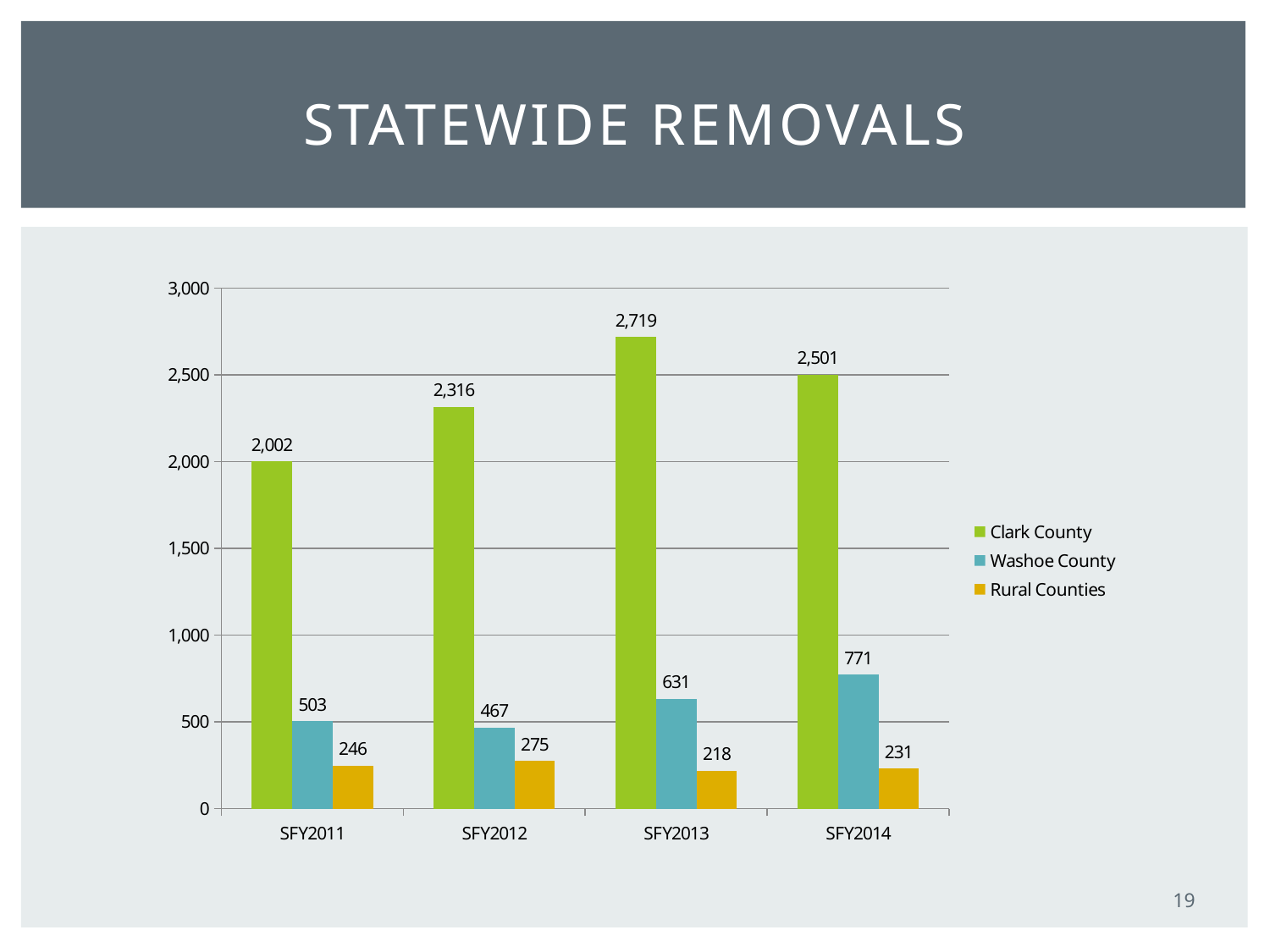
Is the Clark County value for SFY2012 greater or less than 2,500? less How many series does the legend list? 3 Which is larger, the Washoe County value in SFY2011 or in SFY2012? SFY2011 What is the value for Washoe County in SFY2014? 771 In which year is the Rural Counties value lowest? SFY2013 What is the value for Rural Counties in SFY2012? 275 What kind of chart is shown on the slide? bar chart What is the title of the chart? STATEWIDE REMOVALS In which year is the Clark County value highest? SFY2013 What is the value for Clark County in SFY2013? 2,719 What is the difference between the Clark County values for SFY2013 and SFY2014? 218 How many years are shown on the x axis? 4